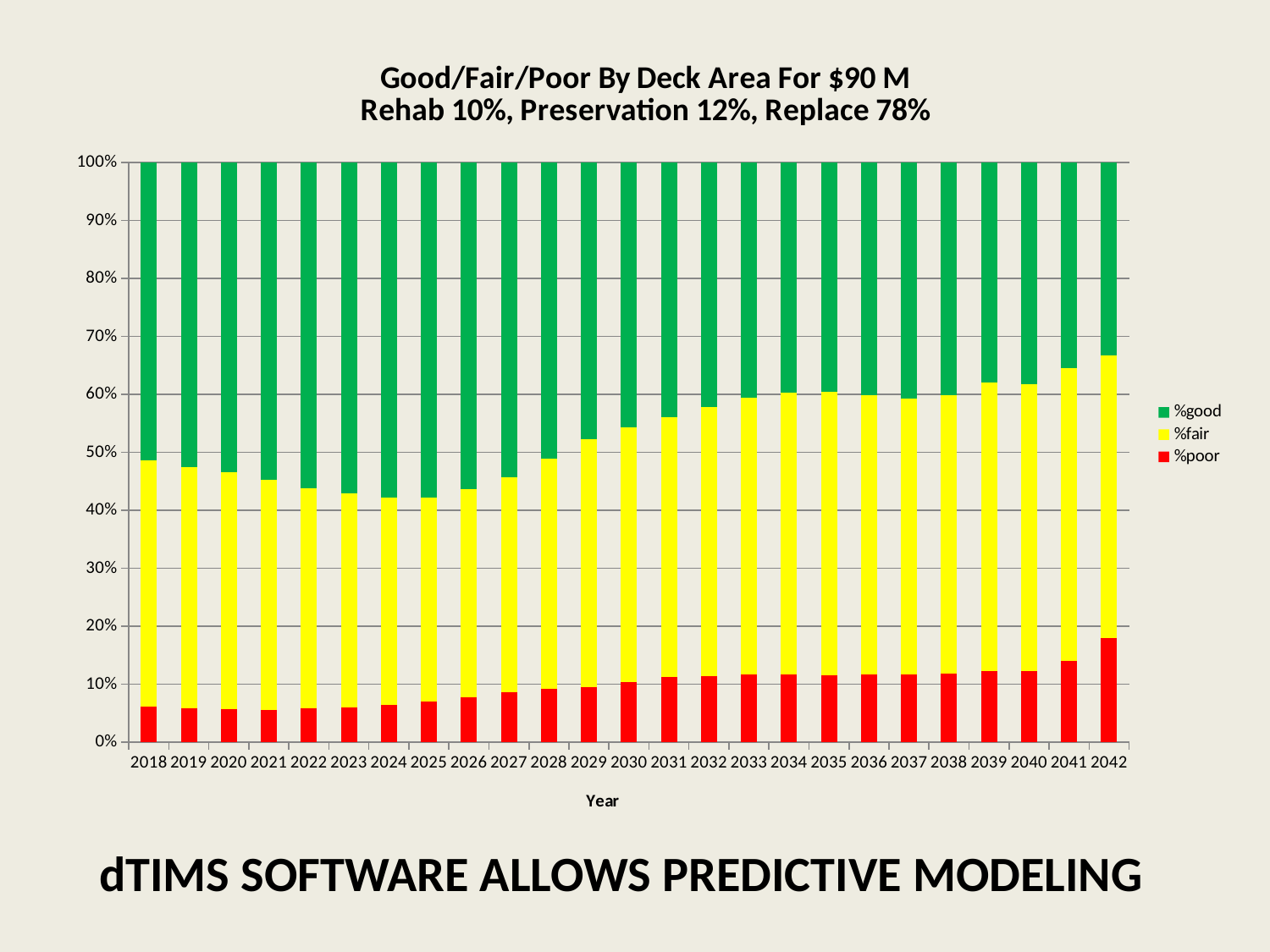
Does the %good share rise or fall from 2018 to 2042? Falls Is the %poor value for 2018 greater or less than 10%? less How many series does the legend list? 3 What is the label on the x axis? Year Is the %poor value for 2042 greater or less than 10%? greater Which year has the larger %poor value, 2018 or 2042? 2042 What do the three segments of each bar add up to? 100% What kind of chart is shown on the slide? Stacked bar chart Does the %poor share rise or fall from 2018 to 2042? Rises How many years are shown along the x axis? 25 Which year has the highest %poor value? 2042 Is the %good value for 2042 greater or less than 40%? less